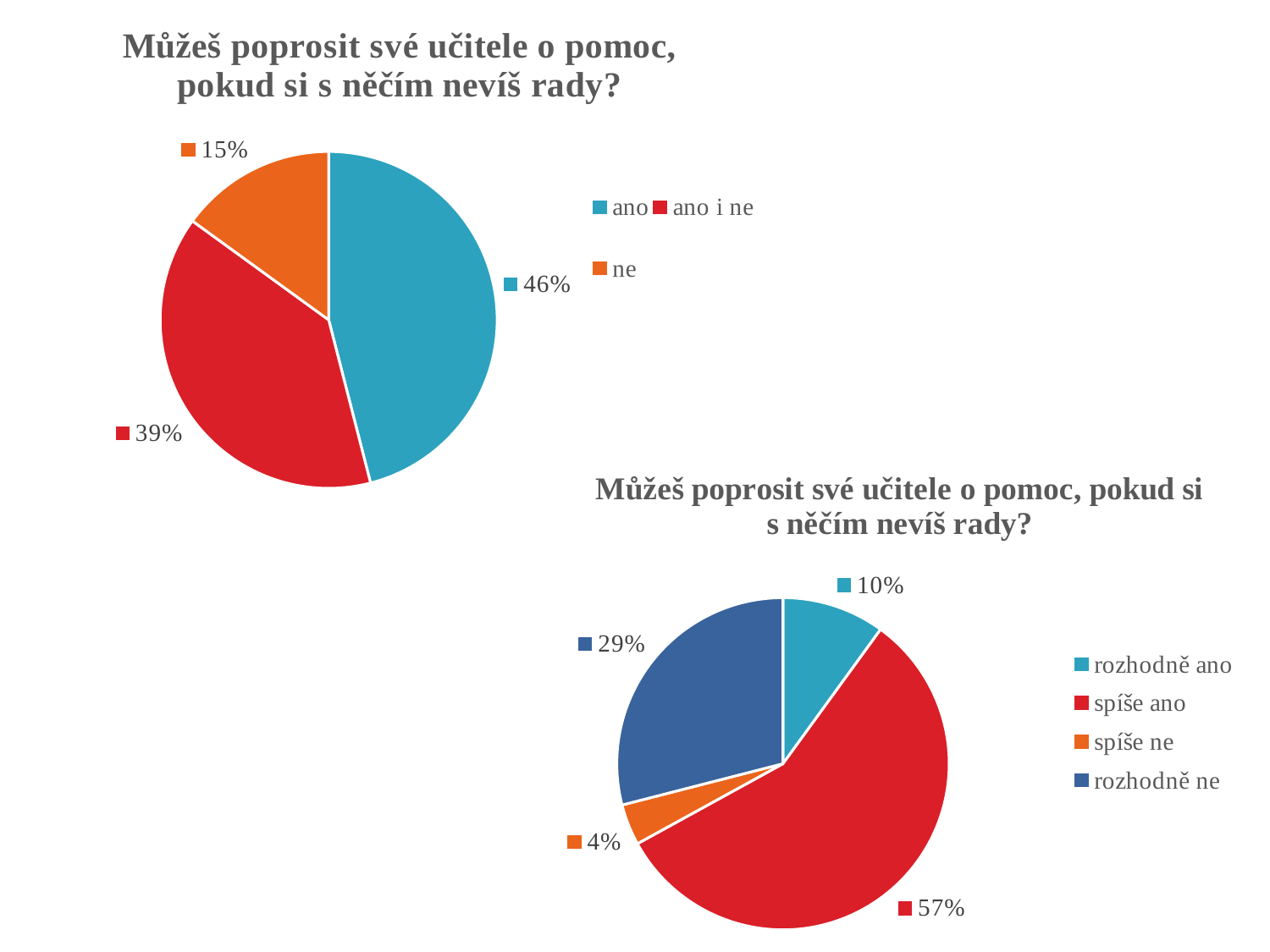
In the top-left pie chart, which answer has the largest share? ano In the top-left pie chart, what is the difference in percentage points between "ano" and "ano i ne"? 7 What type of chart is the bottom-right chart? pie chart How many categories does the legend of the top-left pie chart list? 3 In the bottom-right pie chart, what share of respondents answered "spíše ano"? 57% In the top-left pie chart, which answer has the smallest share? ne In the top-left pie chart, what share of respondents answered "ne"? 15% In the bottom-right pie chart, what share of respondents answered "rozhodně ne"? 29% In the bottom-right pie chart, which answer has the smallest share? spíše ne In the bottom-right pie chart, which is larger: "rozhodně ano" or "rozhodně ne"? rozhodně ne How many slices does the bottom-right pie chart have? 4 In the top-left pie chart, what share of respondents answered "ano"? 46%